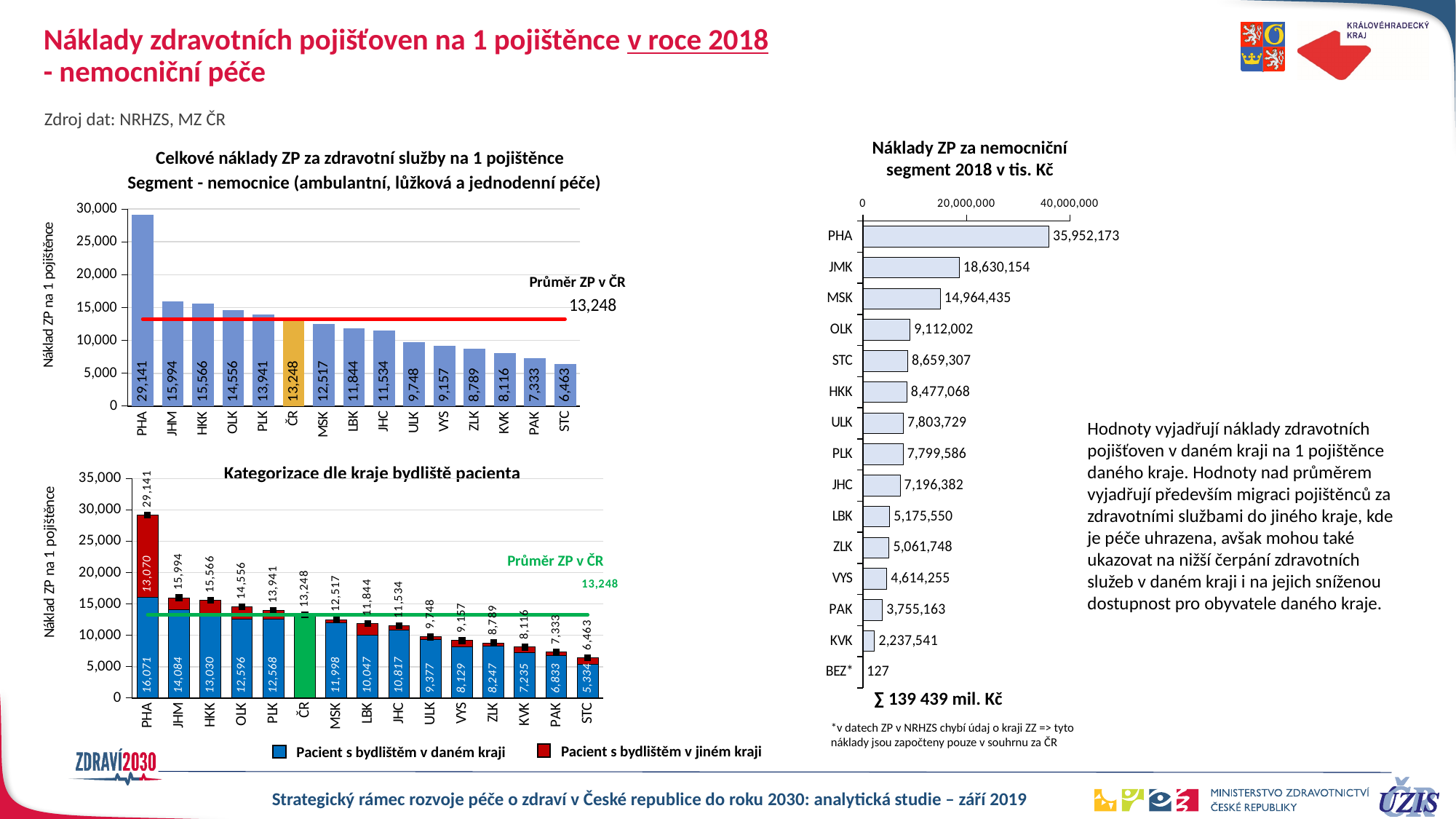
In the top-left chart 'Celkové náklady ZP za zdravotní služby na 1 pojištěnce', what is the difference between the values for PHA and JHM? 13,147 In the bottom-left chart 'Kategorizace dle kraje bydliště pacienta', which is larger for PHA: 'Pacient s bydlištěm v daném kraji' or 'Pacient s bydlištěm v jiném kraji'? Pacient s bydlištěm v daném kraji In the top-left chart 'Celkové náklady ZP za zdravotní služby na 1 pojištěnce', which category has the highest value? PHA In the bottom-left chart 'Kategorizace dle kraje bydliště pacienta', what is the total of the stacked bar for OLK? 14,556 In the top-left chart 'Celkové náklady ZP za zdravotní služby na 1 pojištěnce', which category has the lowest value? STC What type of chart is the right chart 'Náklady ZP za nemocniční segment 2018 v tis. Kč'? Bar chart In the right chart 'Náklady ZP za nemocniční segment 2018 v tis. Kč', what is the difference between the values for JMK and MSK? 3,665,719 In the bottom-left chart 'Kategorizace dle kraje bydliště pacienta', what is the value of 'Pacient s bydlištěm v daném kraji' for PHA? 16,071 In the right chart 'Náklady ZP za nemocniční segment 2018 v tis. Kč', what is the value for MSK? 14,964,435 In the top-left chart 'Celkové náklady ZP za zdravotní služby na 1 pojištěnce', what is the value of the 'Průměr ZP v ČR' line? 13,248 In the bottom-left chart 'Kategorizace dle kraje bydliště pacienta', how many series does the legend list? 2 In the top-left chart 'Celkové náklady ZP za zdravotní služby na 1 pojištěnce', what is the value for HKK? 15,566